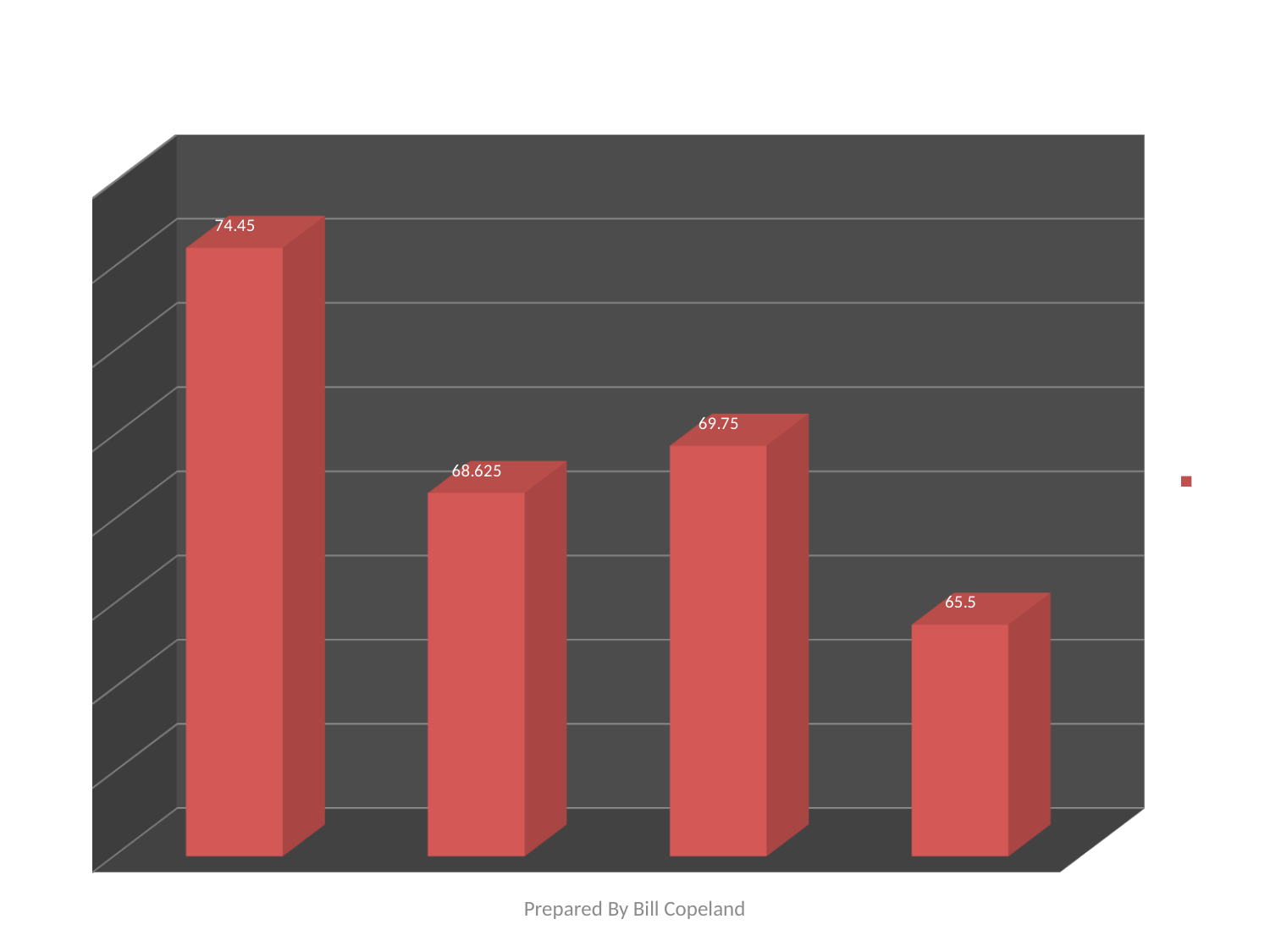
What is the difference between the third bar's value and the second bar's value? 1.125 Which is larger, the value of the second bar or the value of the third bar? The third bar (69.75) Which bar has the highest value? The leftmost bar (74.45) What is the value shown on the second bar from the left? 68.625 Which bar has the lowest value? The rightmost bar (65.5) What is the value shown on the leftmost bar? 74.45 What is the difference between the leftmost bar's value and the rightmost bar's value? 8.95 What text appears below the chart? Prepared By Bill Copeland What is the value shown on the third bar from the left? 69.75 What is the value shown on the rightmost bar? 65.5 What kind of chart is shown on the slide? Bar chart How many bars are plotted in the chart? 4